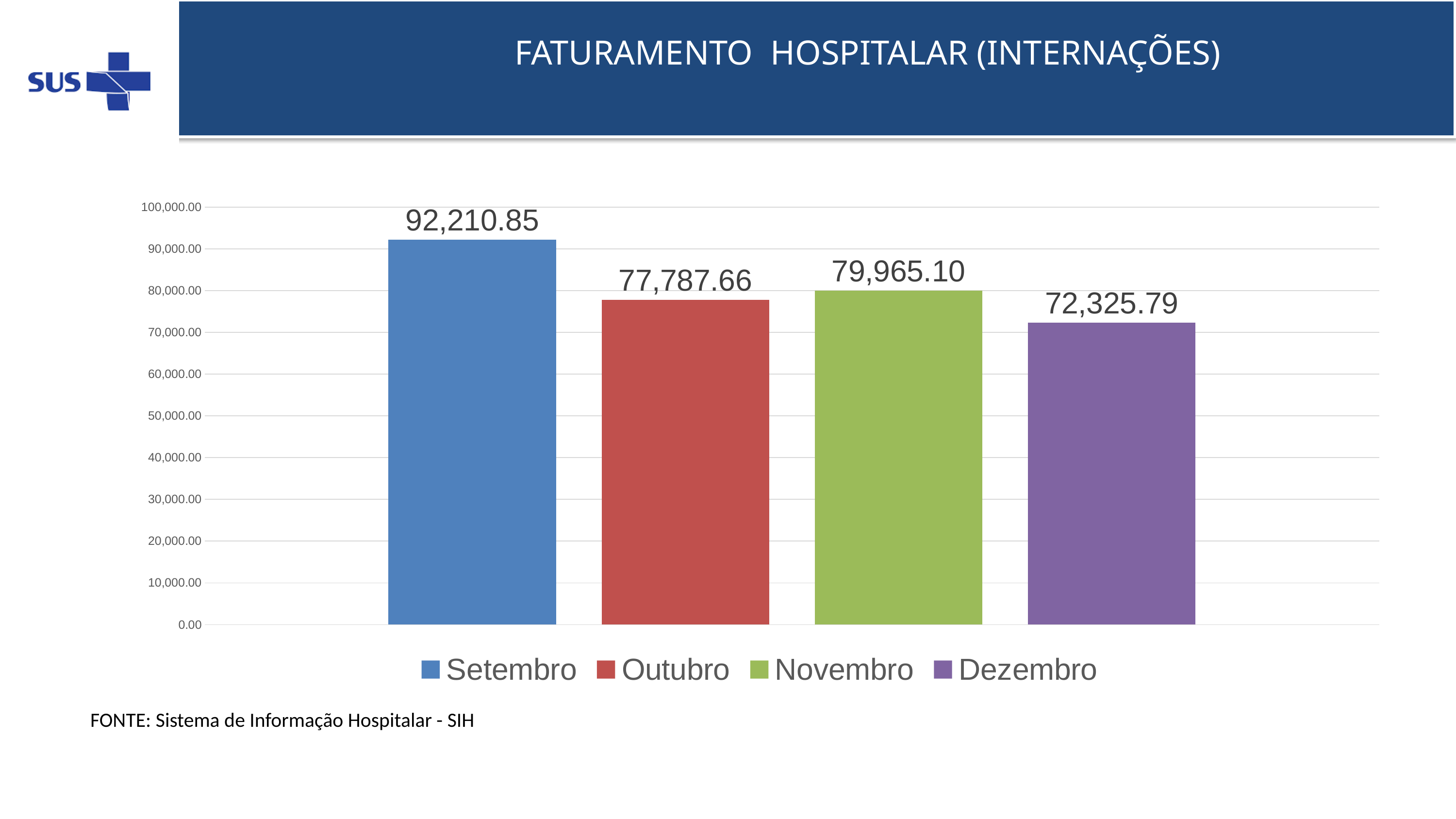
How many bars are shown in the chart? 4 Which month has the lowest value? Dezembro What is the difference between the values for Setembro and Outubro? 14,423.19 Which month has the highest value? Setembro What kind of chart is shown on the slide? Bar chart Which is larger, the value for Outubro or the value for Novembro? Novembro What is the value for Dezembro? 72,325.79 What is the title of the slide containing the chart? FATURAMENTO HOSPITALAR (INTERNAÇÕES) What is the difference between the values for Novembro and Dezembro? 7,639.31 What is the value for Setembro? 92,210.85 What is the value for Novembro? 79,965.10 What is the value for Outubro? 77,787.66